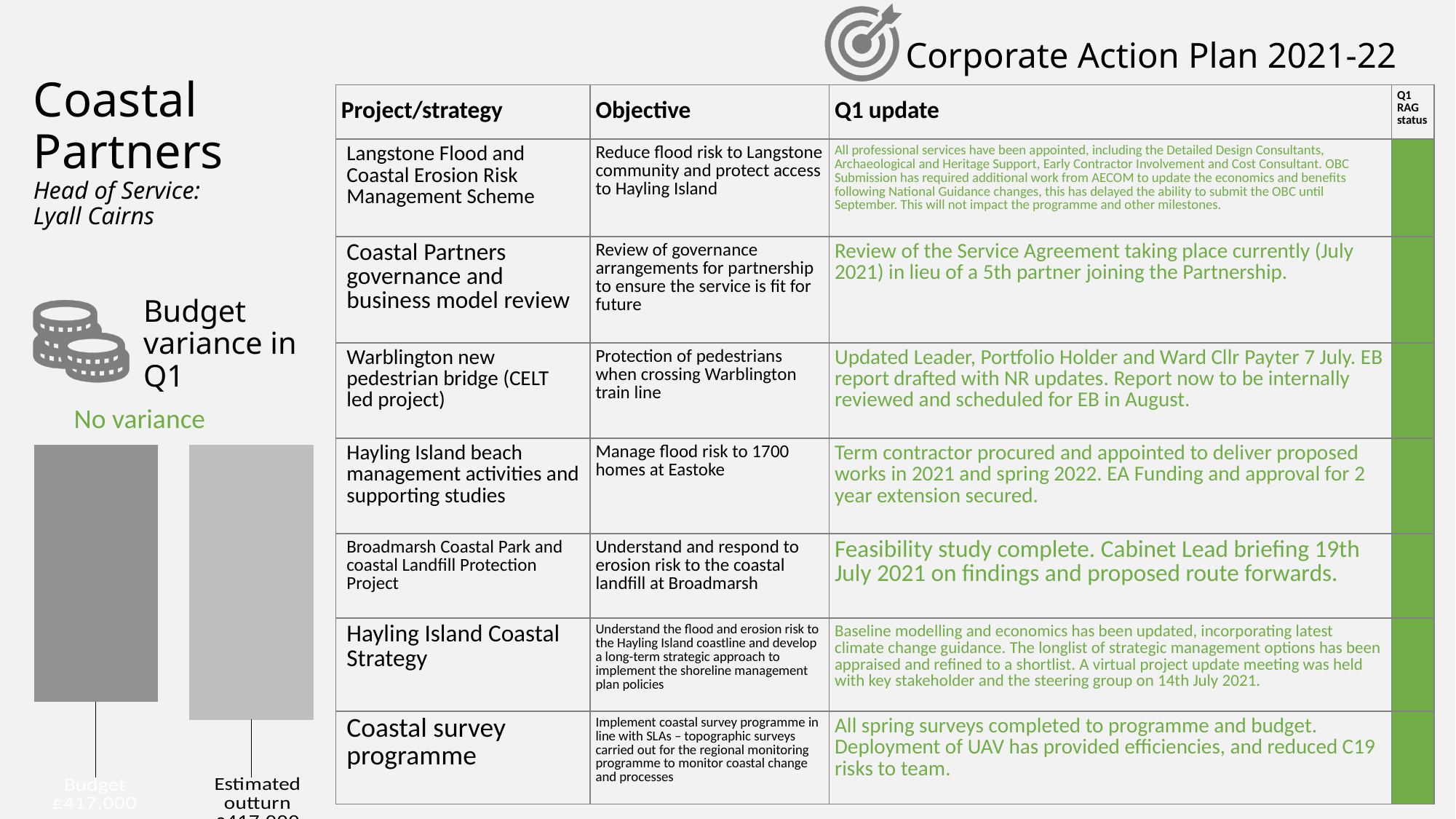
What are the labels of the two bars in the 'Budget variance in Q1' chart? Budget and Estimated outturn How many bars does the 'Budget variance in Q1' chart show? 2 What text is shown in green above the 'Budget variance in Q1' chart describing the variance? No variance What kind of chart is shown under the 'Budget variance in Q1' heading? bar chart What is the Budget value shown on the 'Budget variance in Q1' chart? £417,000 Which bar in the 'Budget variance in Q1' chart is on the left? Budget